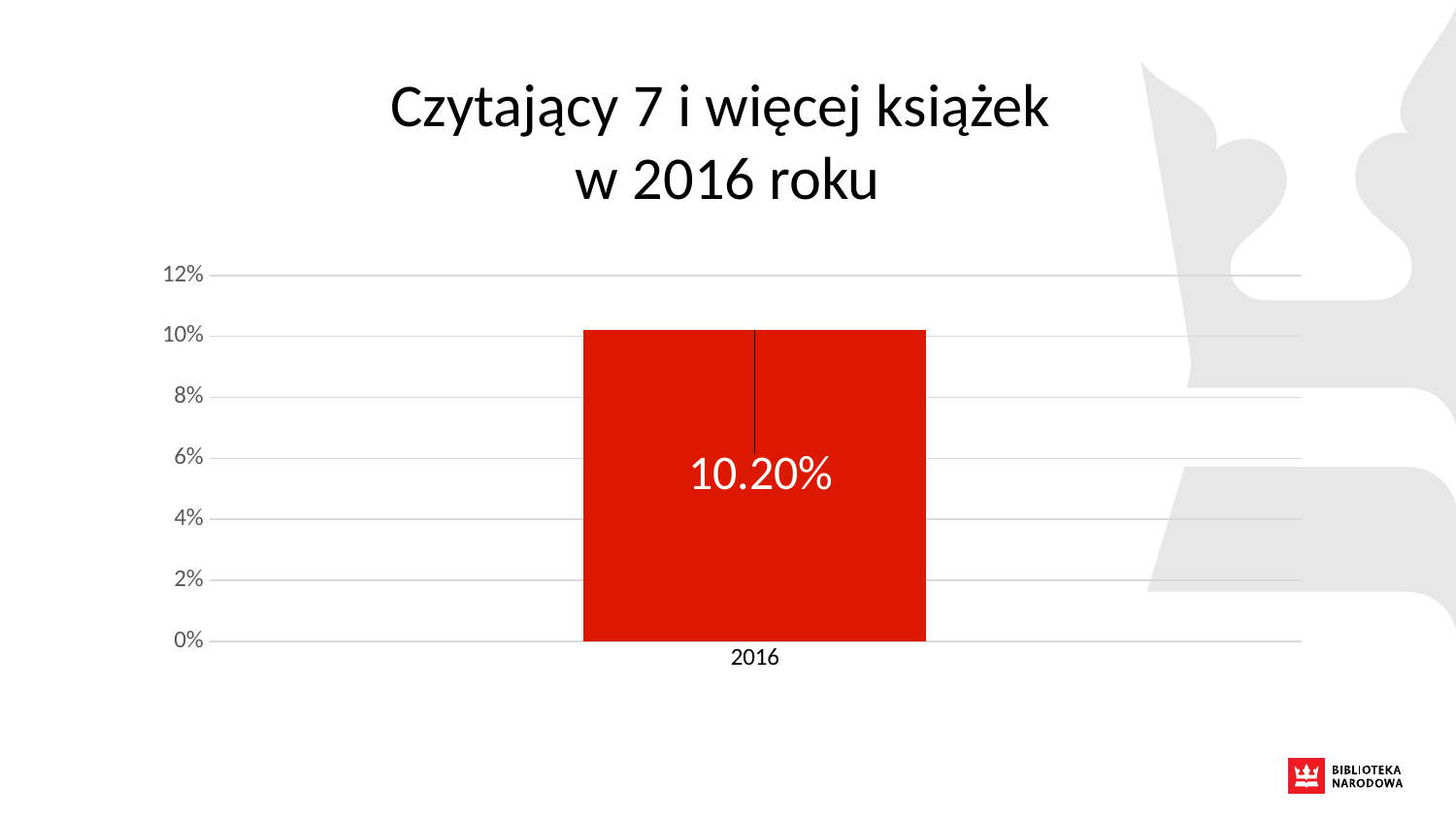
Which year is labelled on the x axis? 2016 Is the value for 2016 greater or less than 12%? less What is the title of the chart? Czytający 7 i więcej książek w 2016 roku How many categories are plotted on the x axis? 1 What kind of chart is shown on the slide? bar chart What is the highest value shown on the y axis? 12% What is the value shown for 2016? 10.20% Is the value for 2016 greater or less than 10%? greater